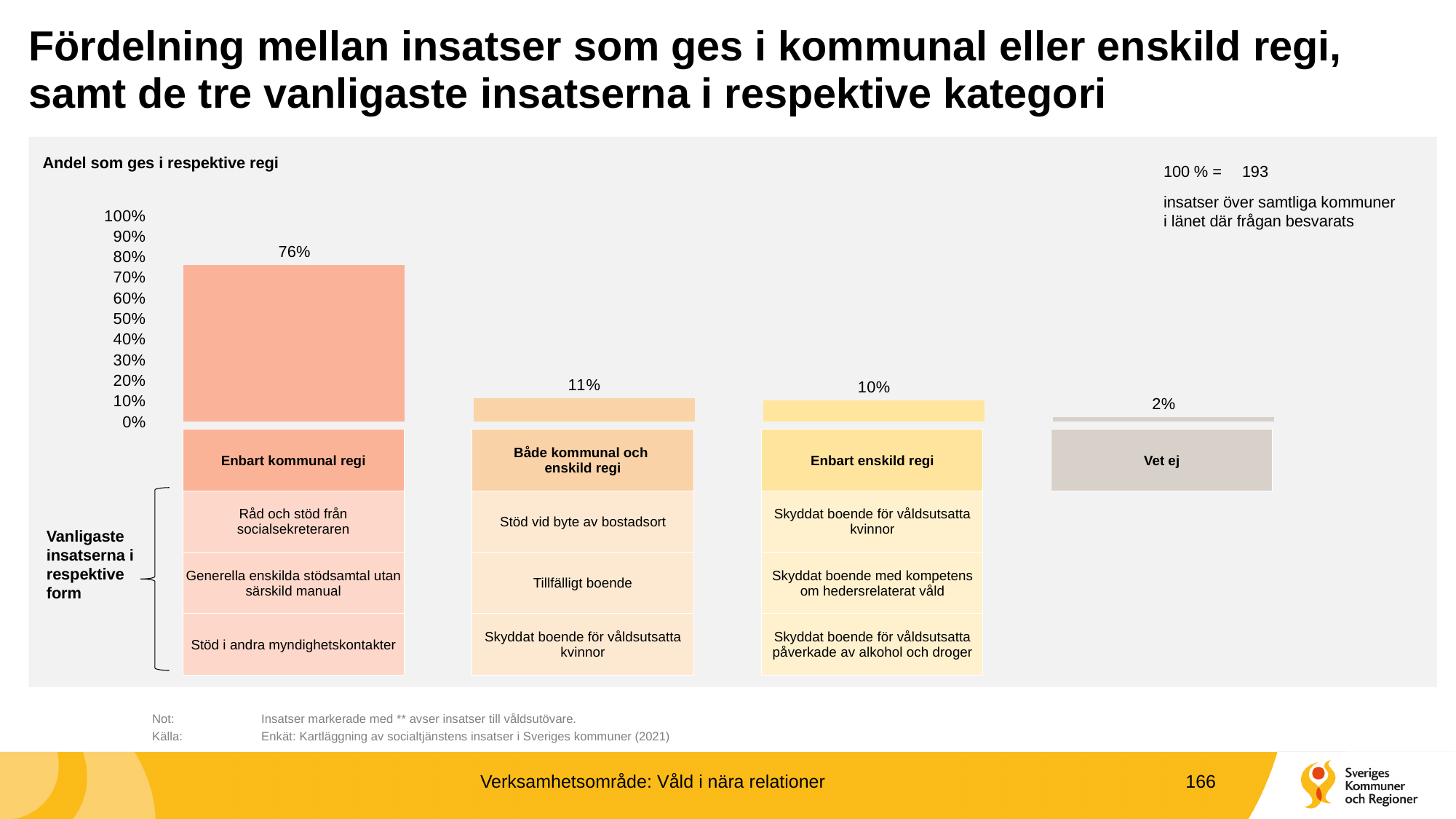
What is the value for "Enbart enskild regi"? 10% Which is larger, the value for "Både kommunal och enskild regi" or the value for "Vet ej"? Både kommunal och enskild regi What is the value for "Enbart kommunal regi"? 76% According to the note on the slide, how many insatser does 100% correspond to? 193 How many categories are shown in the bar chart? 4 Which category has the highest value? Enbart kommunal regi Which category has the lowest value? Vet ej Is the value for "Enbart kommunal regi" greater or less than 50%? greater What is the value for "Vet ej"? 2% What is the value for "Både kommunal och enskild regi"? 11% What is the difference between the values for "Enbart kommunal regi" and "Enbart enskild regi"? 66 percentage points What kind of chart is shown on the slide? Bar chart